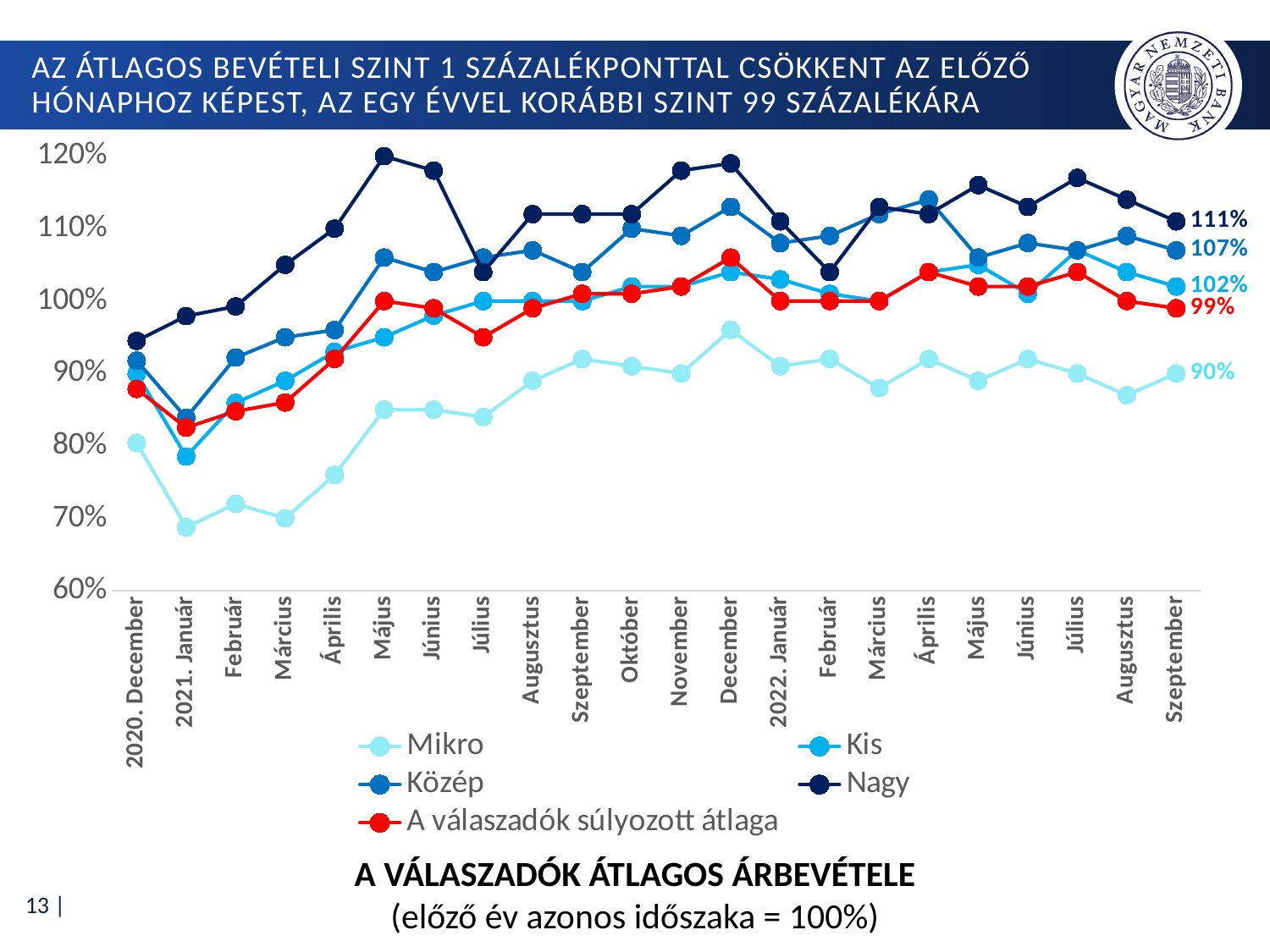
Which series has the lowest value in 2022 Szeptember? Mikro In 2022 Szeptember, what is the difference between the Nagy and Mikro values? 21 percentage points What is the value of 'A válaszadók súlyozott átlaga' in 2022 Szeptember? 99% Is the Nagy value for 2021 Május greater or less than 110%? greater What is the value of the Nagy series in 2022 Szeptember? 111% Is the Mikro value for 2021. Január greater or less than 70%? less Which series has the highest value in 2022 Szeptember? Nagy What is the value of the Mikro series in 2022 Szeptember? 90% What is the value of the Közép series in 2022 Szeptember? 107% How many series does the legend list? 5 What is the value of the Kis series in 2022 Szeptember? 102% What kind of chart is shown on the slide? line chart